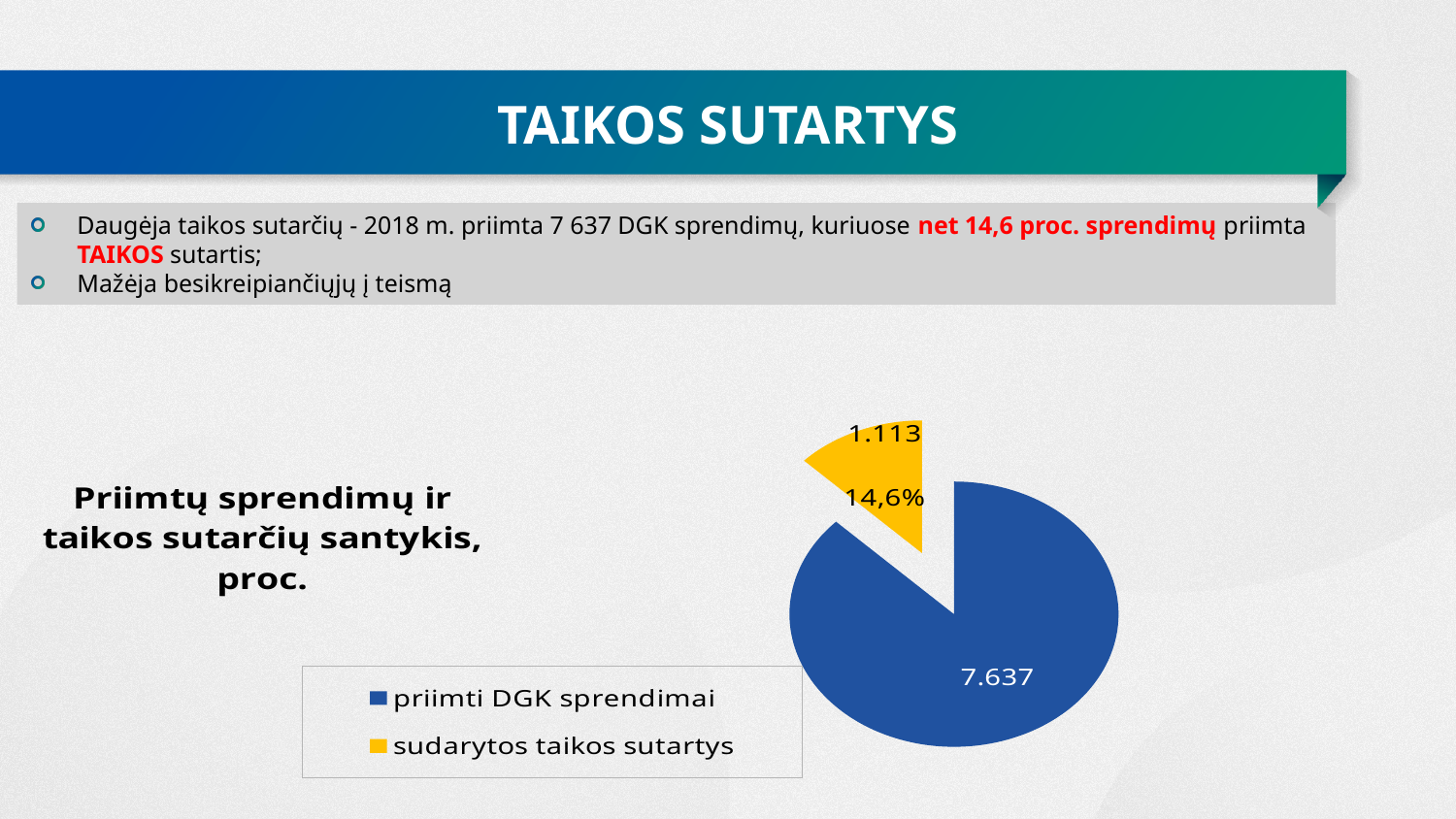
What colour is the sudarytos taikos sutartys slice? yellow Which is larger, priimti DGK sprendimai or sudarytos taikos sutartys? priimti DGK sprendimai What percentage is labelled on the sudarytos taikos sutartys slice? 14,6% What value is shown for sudarytos taikos sutartys? 1.113 What type of chart is shown on the slide? pie chart How many entries does the legend list? 2 Which slice is the smallest in the pie chart? sudarytos taikos sutartys What value is shown for priimti DGK sprendimai? 7.637 What is the title of the chart? Priimtų sprendimų ir taikos sutarčių santykis, proc. How many slices does the pie chart have? 2 Which slice is the largest in the pie chart? priimti DGK sprendimai What is the difference between the values for priimti DGK sprendimai and sudarytos taikos sutartys? 6.524